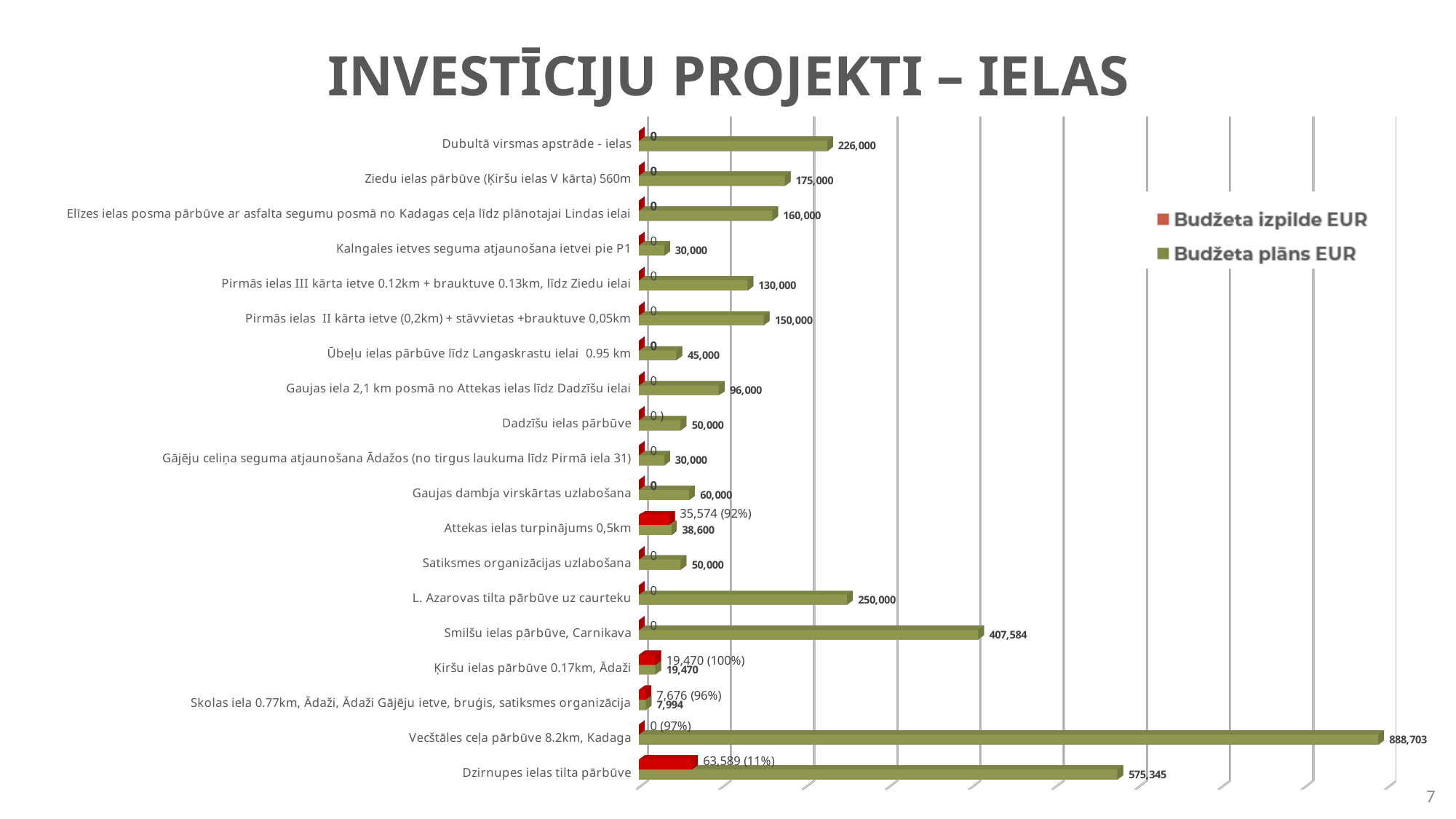
How many series does the legend list? 2 What is the difference in Budžeta plāns EUR between Vecštāles ceļa pārbūve 8.2km, Kadaga and Dzirnupes ielas tilta pārbūve? 313,358 What kind of chart is shown on the slide? bar chart What is the Budžeta plāns EUR value for Smilšu ielas pārbūve, Carnikava? 407,584 How many categories (projects) are plotted on the chart? 19 Which project has the highest Budžeta plāns EUR value? Vecštāles ceļa pārbūve 8.2km, Kadaga Which has a larger Budžeta plāns EUR value: L. Azarovas tilta pārbūve uz caurteku or Dubultā virsmas apstrāde - ielas? L. Azarovas tilta pārbūve uz caurteku Which colour represents the Budžeta izpilde EUR series in the legend? red What is the Budžeta izpilde EUR value for Dzirnupes ielas tilta pārbūve? 63,589 (11%) What is the Budžeta plāns EUR value for Attekas ielas turpinājums 0,5km? 38,600 Which project has the lowest Budžeta plāns EUR value? Skolas iela 0.77km, Ādaži, Ādaži Gājēju ietve, bruģis, satiksmes organizācija What is the Budžeta plāns EUR value for Vecštāles ceļa pārbūve 8.2km, Kadaga? 888,703